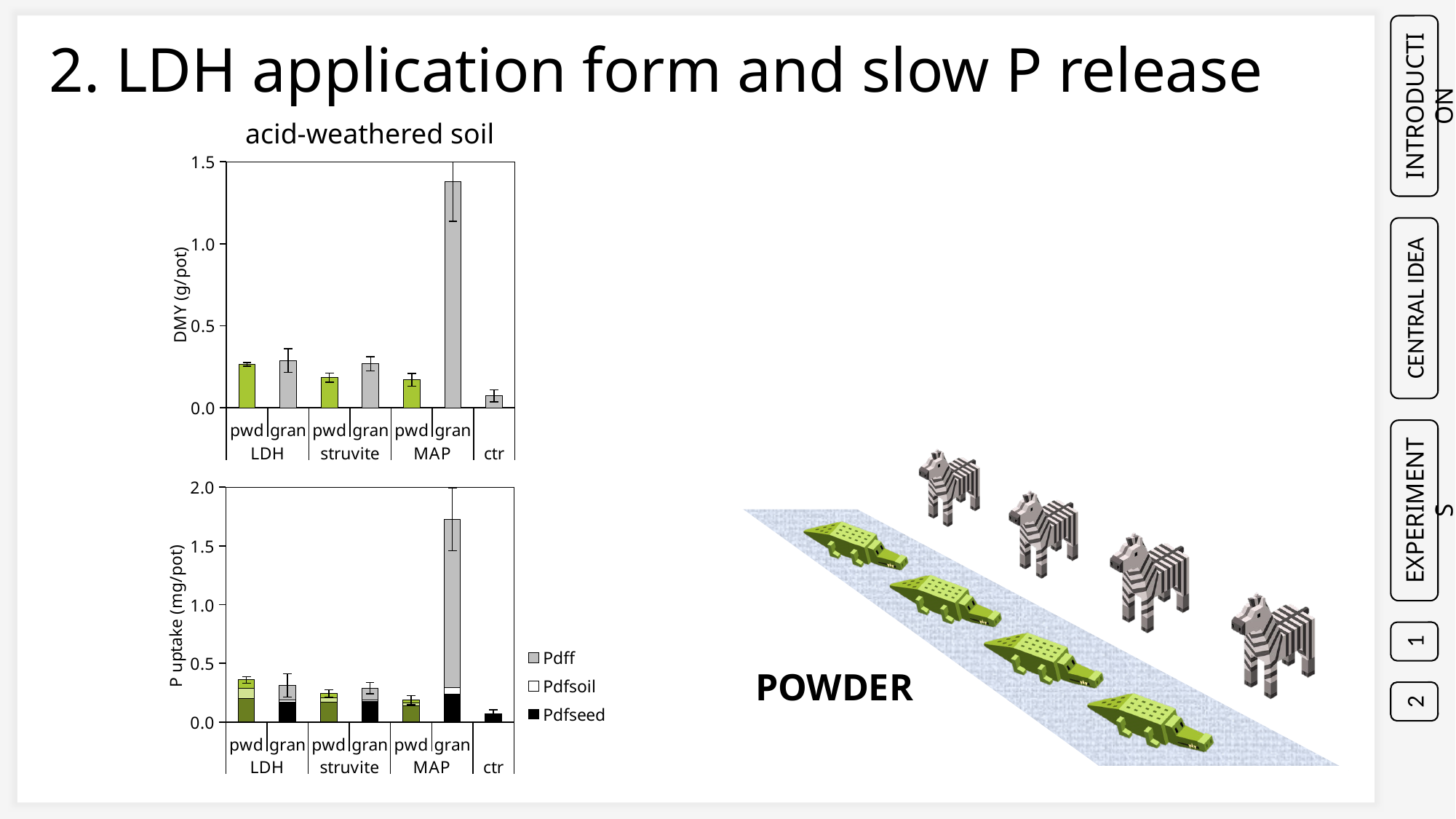
In the bottom chart (P uptake), is the total for MAP gran greater or less than 1.5? greater In the top chart (DMY), is the value for LDH pwd greater or less than 0.5? less How many bars are plotted in the top chart (DMY)? 7 What is the y-axis label of the top chart? DMY (g/pot) What kind of chart is the top chart titled 'acid-weathered soil'? bar chart In the top chart (DMY), which bar is the lowest? ctr In the bottom chart (P uptake), which is larger, the total for MAP gran or the total for LDH pwd? MAP gran In the bottom chart (P uptake), which bar has the lowest total? ctr In the bottom chart (P uptake), how many series does the legend list? 3 In the top chart (DMY), which bar is the highest? MAP gran In the top chart (DMY), is the value for MAP gran greater or less than 1.0? greater In the bottom chart (P uptake), which bar has the highest total? MAP gran